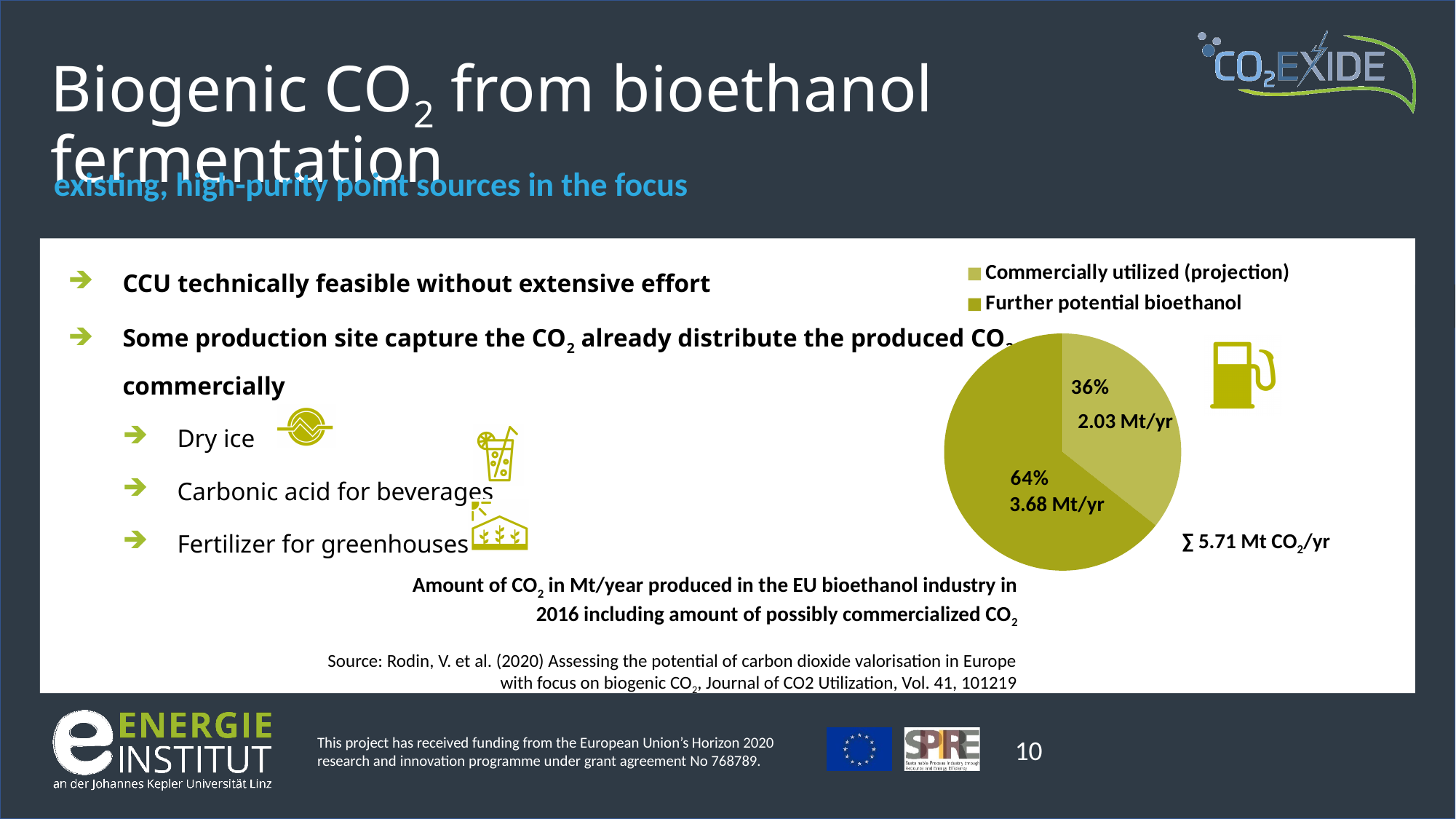
How many entries does the legend of the pie chart list? 2 What share of the pie does 'Commercially utilized (projection)' represent? 36% Which is larger, 'Commercially utilized (projection)' or 'Further potential bioethanol'? Further potential bioethanol How many slices does the pie chart have? 2 What is the value in Mt/yr for 'Further potential bioethanol'? 3.68 Mt/yr What share of the pie does 'Further potential bioethanol' represent? 64% What is the value in Mt/yr for 'Commercially utilized (projection)'? 2.03 Mt/yr What total amount of CO2 per year is stated next to the pie chart? 5.71 Mt CO2/yr Which slice of the pie chart is the largest? Further potential bioethanol What is the difference in Mt/yr between 'Further potential bioethanol' and 'Commercially utilized (projection)'? 1.65 Mt/yr Which slice of the pie chart is the smallest? Commercially utilized (projection) What kind of chart is shown on the slide? pie chart